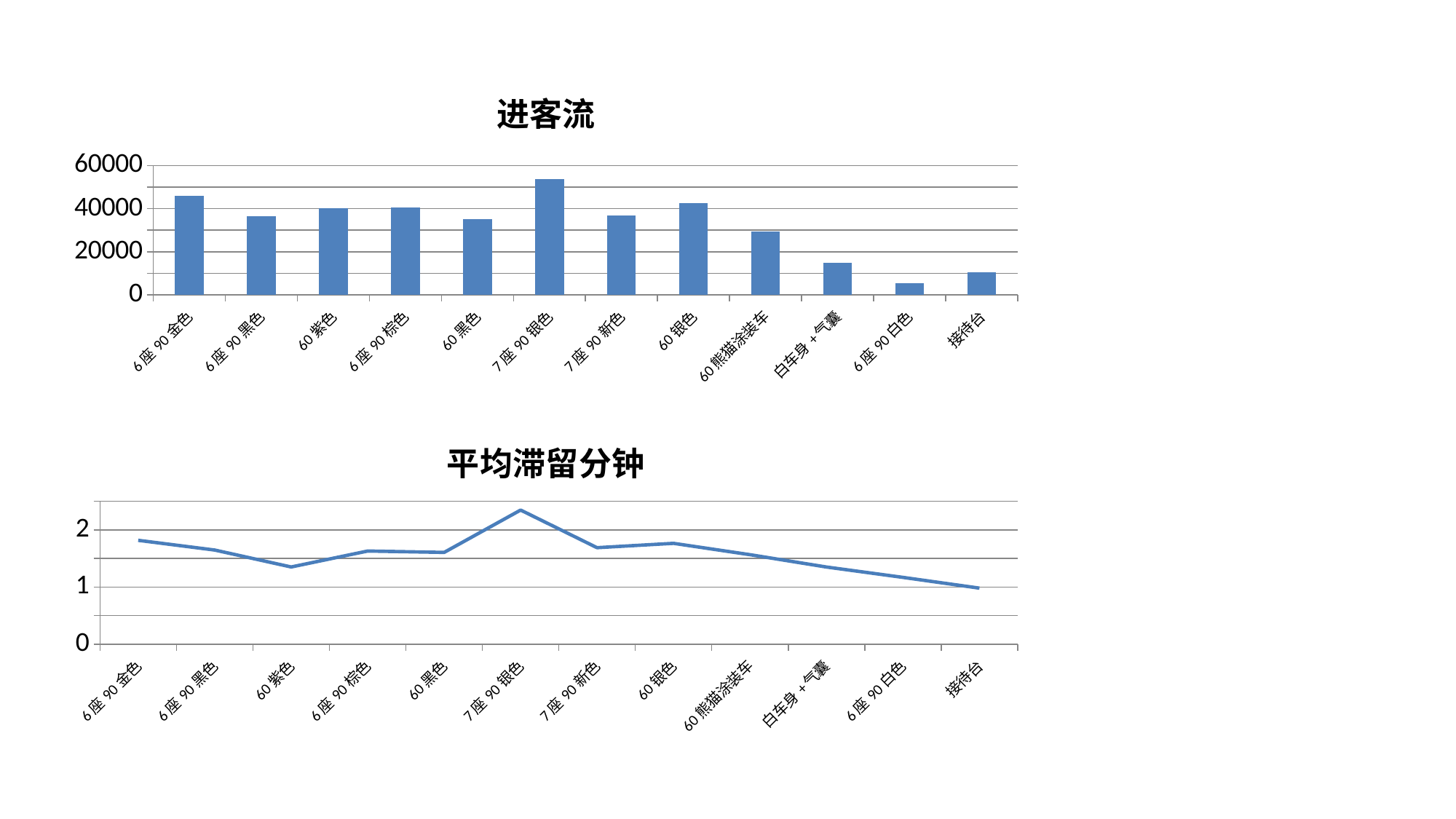
What kind of chart is the 进客流 chart? bar chart How many categories are shown on the x axis of the 进客流 chart? 12 What kind of chart is the 平均滞留分钟 chart? line chart In the 进客流 chart, is the value for 白车身 + 气囊 greater or less than 20000? less In the 进客流 chart, which is larger, the value for 7座 90 银色 or the value for 60 熊猫涂装车? 7座 90 银色 In the 平均滞留分钟 chart, which category has the lowest value? 接待台 In the 平均滞留分钟 chart, is the value for 7座 90 银色 greater or less than 2? greater In the 平均滞留分钟 chart, do the values rise or fall from 60 银色 to 接待台? fall In the 平均滞留分钟 chart, which category has the highest value? 7座 90 银色 In the 进客流 chart, which category has the lowest value? 6座 90 白色 In the 进客流 chart, which category has the highest value? 7座 90 银色 In the 进客流 chart, is the value for 6座 90 金色 greater or less than 40000? greater